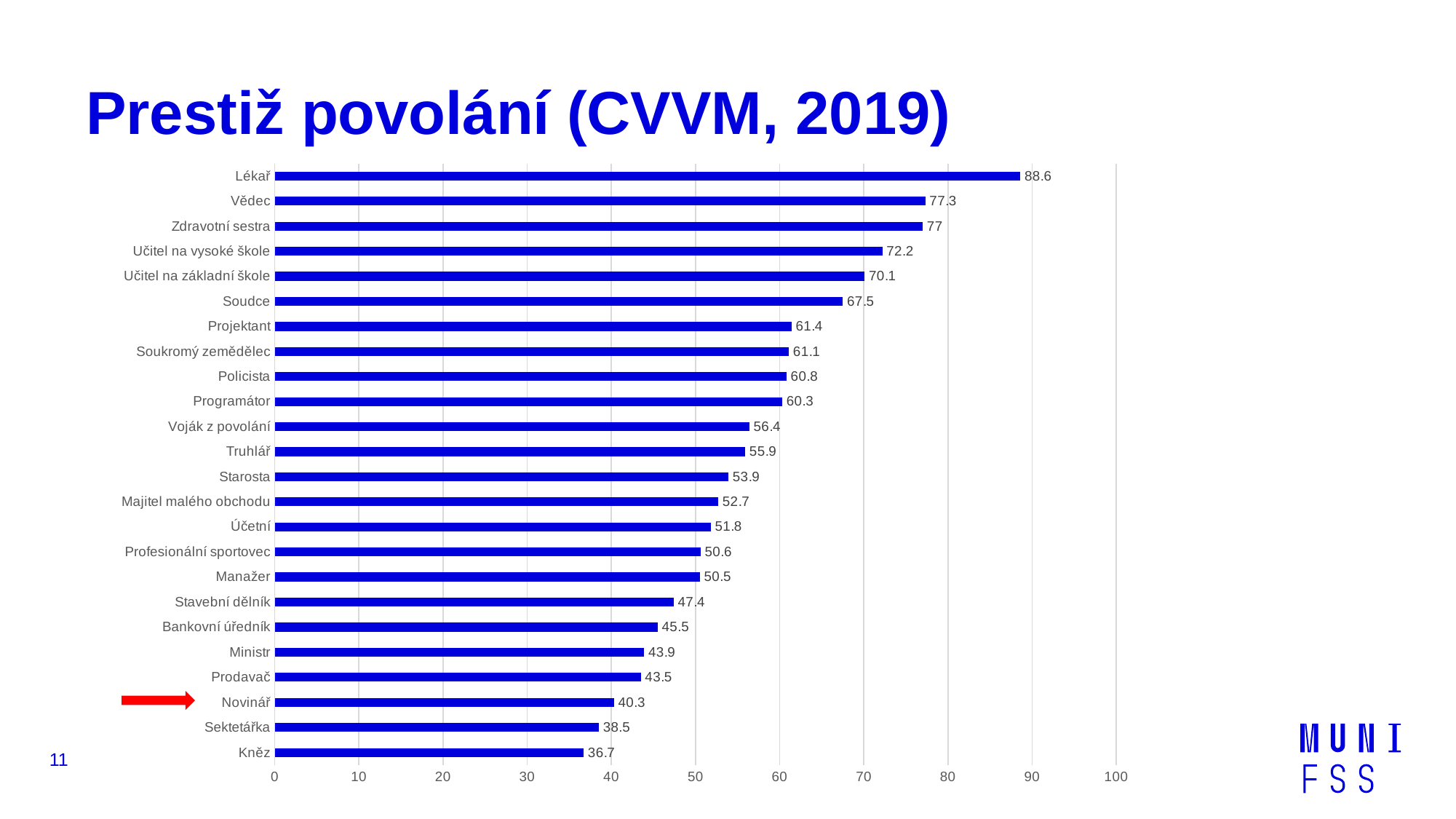
Which has a larger value, Soudce or Projektant? Soudce What is the value for Lékař? 88.6 Which has a larger value, Ministr or Stavební dělník? Stavební dělník What is the difference between the values for Lékař and Kněz? 51.9 What is the value for Policista? 60.8 How many occupations are shown in the chart? 24 Which occupation has the highest value? Lékař What is the title of the slide? Prestiž povolání (CVVM, 2019) What kind of chart is shown on the slide? Bar chart What is the value for Novinář? 40.3 What is the difference between the values for Vědec and Novinář? 37 Which occupation has the lowest value? Kněz